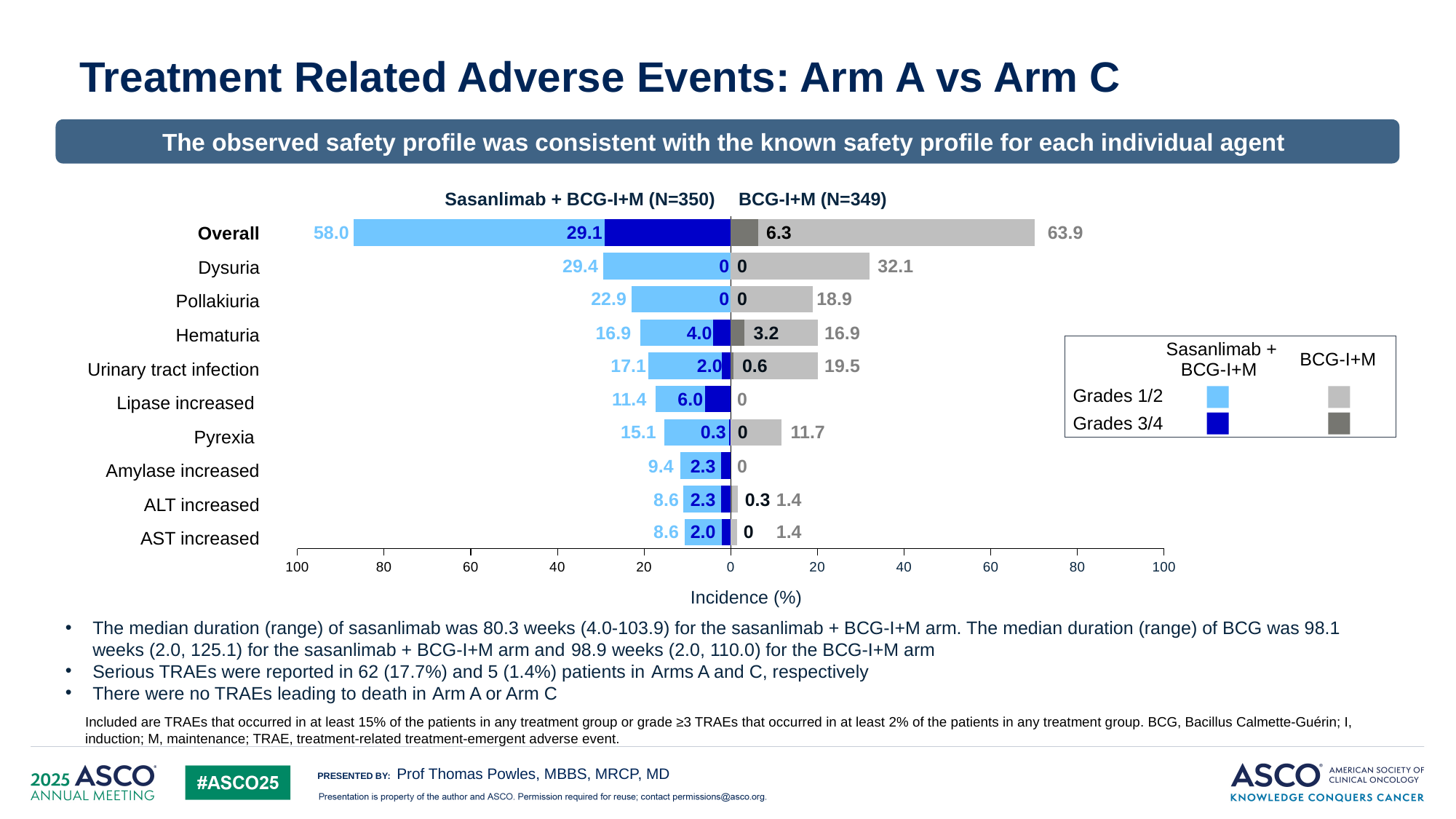
How many adverse event categories are listed on the chart? 10 Which adverse event category has the highest Grades 1/2 incidence in the Sasanlimab + BCG-I+M arm? Overall What is the Grades 3/4 incidence of Overall TRAEs in the BCG-I+M arm? 6.3 How many series does the legend list? 4 Which is larger: the Grades 1/2 incidence of Pollakiuria in the Sasanlimab + BCG-I+M arm or in the BCG-I+M arm? Sasanlimab + BCG-I+M What is the Grades 1/2 incidence of Overall TRAEs in the Sasanlimab + BCG-I+M arm? 58.0 Excluding Overall, which adverse event has the highest Grades 3/4 incidence in the Sasanlimab + BCG-I+M arm? Lipase increased What is the Grades 1/2 incidence of Dysuria in the BCG-I+M arm? 32.1 Is the total Overall TRAE bar for the Sasanlimab + BCG-I+M arm greater or less than 80? greater What is the difference between the Grades 1/2 incidence of Overall TRAEs in the BCG-I+M arm and the Sasanlimab + BCG-I+M arm? 5.9 What kind of chart is shown on the slide? Bar chart What is the Grades 3/4 incidence of Lipase increased in the Sasanlimab + BCG-I+M arm? 6.0